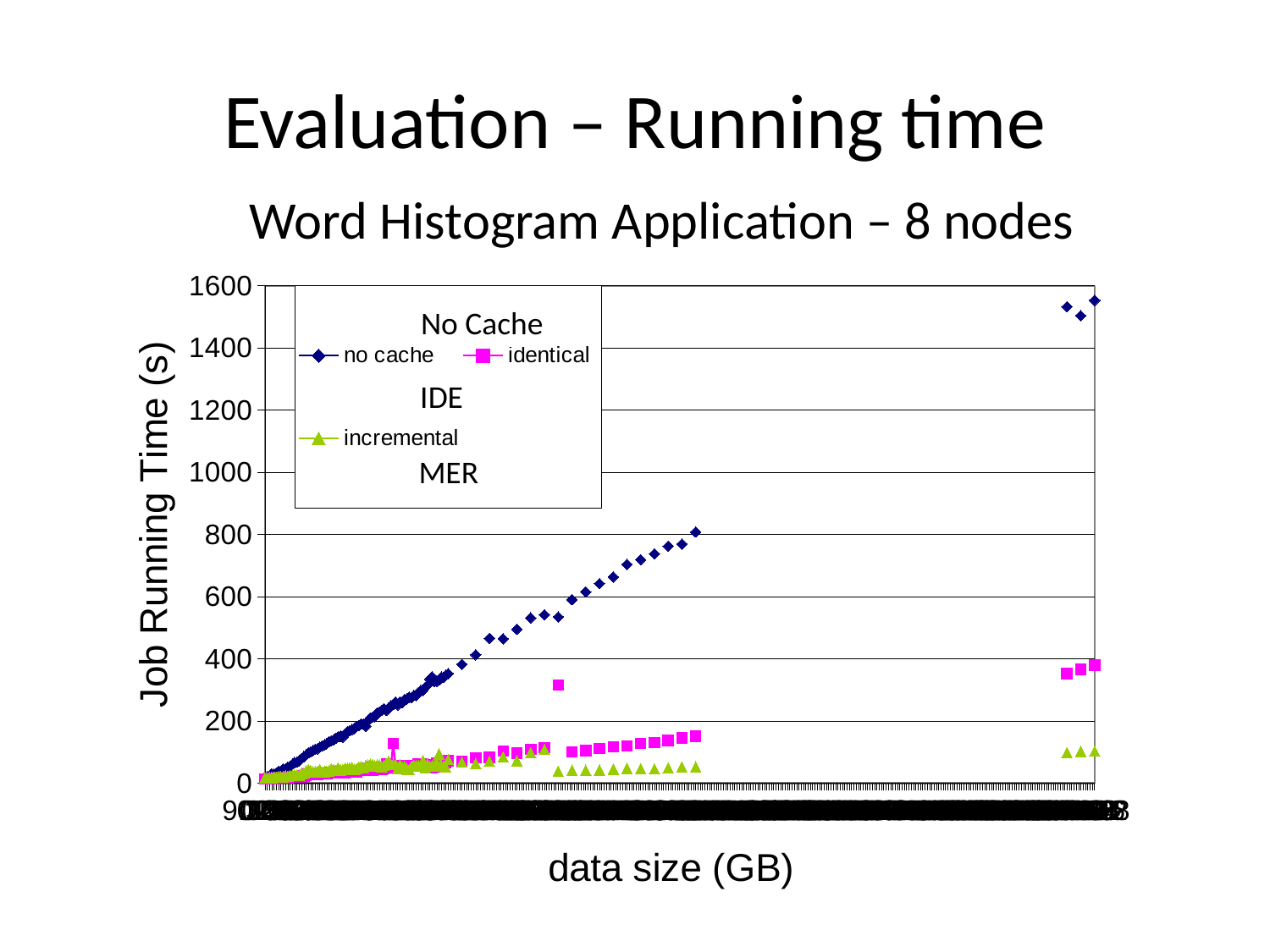
What is the label of the x axis? data size (GB) At the right end of the chart, which series has the larger job running time, no cache or identical? no cache Which series reaches the highest job running time on the chart? no cache How many series does the chart legend list? 3 Are the rightmost values of the incremental series greater or less than 200? less Which series is drawn with green triangle markers? incremental Which series has the lowest job running times at the right end of the chart? incremental Are the rightmost values of the identical series greater or less than 600? less Does the job running time for the no cache series rise or fall as data size increases along the x axis? rise What kind of chart is shown on the slide? line chart What is the label of the y axis? Job Running Time (s) Are the highest values of the no cache series greater or less than 1400? greater